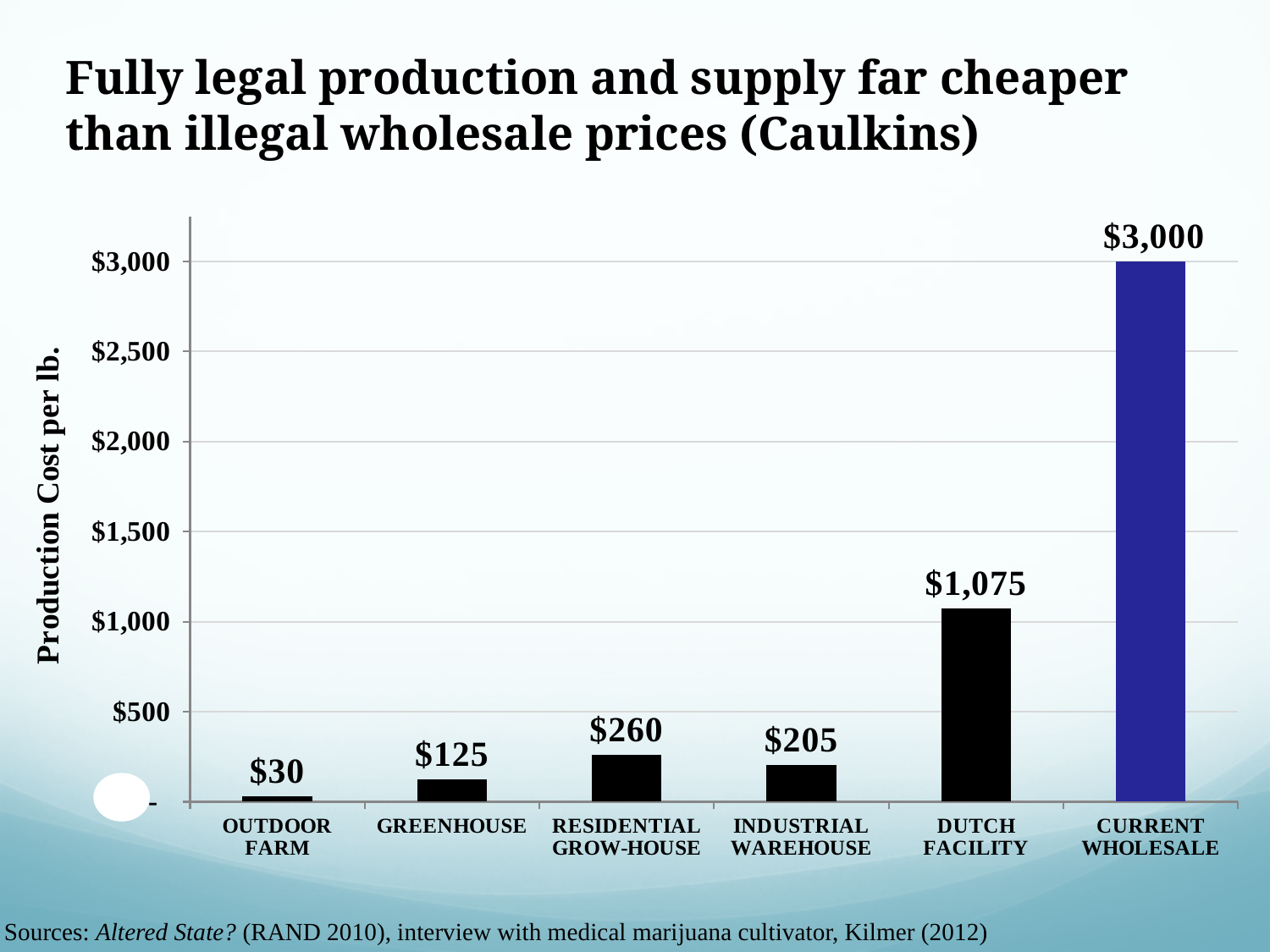
How many categories are shown on the x axis? 6 What is the difference between Current Wholesale and Dutch Facility? $1,925 What is the label of the y axis? Production Cost per lb. Which category has the highest value? Current Wholesale What is the production cost per lb. for Greenhouse? $125 Which category has the lowest value? Outdoor Farm What kind of chart is shown on the slide? bar chart Which is larger, Residential Grow-House or Greenhouse? Residential Grow-House What is the value shown for Industrial Warehouse? $205 What is the difference between Residential Grow-House and Industrial Warehouse? $55 Is the value for Dutch Facility greater or less than $1,000? greater What is the value shown for Dutch Facility? $1,075